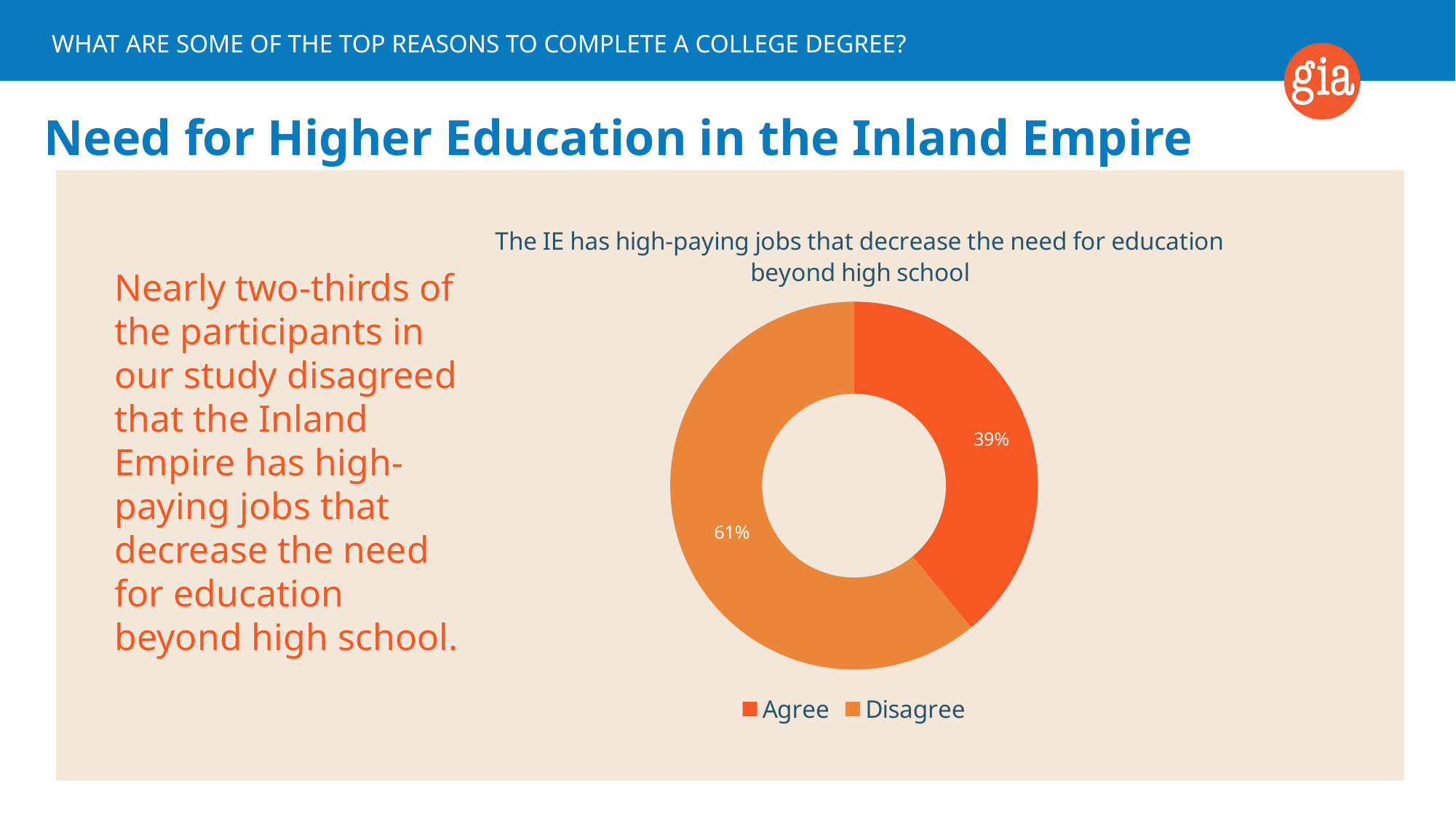
What kind of chart is shown on the slide? Doughnut (pie) chart Is the Agree share larger or smaller than the Disagree share? smaller What are the two legend entries of the chart? Agree and Disagree How many categories does the chart show? 2 Which response has the larger share of the chart, Agree or Disagree? Disagree Do the Agree and Disagree shares add up to 100%? Yes What is the title of the chart? The IE has high-paying jobs that decrease the need for education beyond high school What is the difference in percentage points between the Disagree and Agree shares? 22 What percentage of participants disagreed that the IE has high-paying jobs that decrease the need for education beyond high school? 61% What percentage of participants agreed that the IE has high-paying jobs that decrease the need for education beyond high school? 39% What share of the chart does the Disagree slice represent? 61% Which response has the smaller share of the chart? Agree